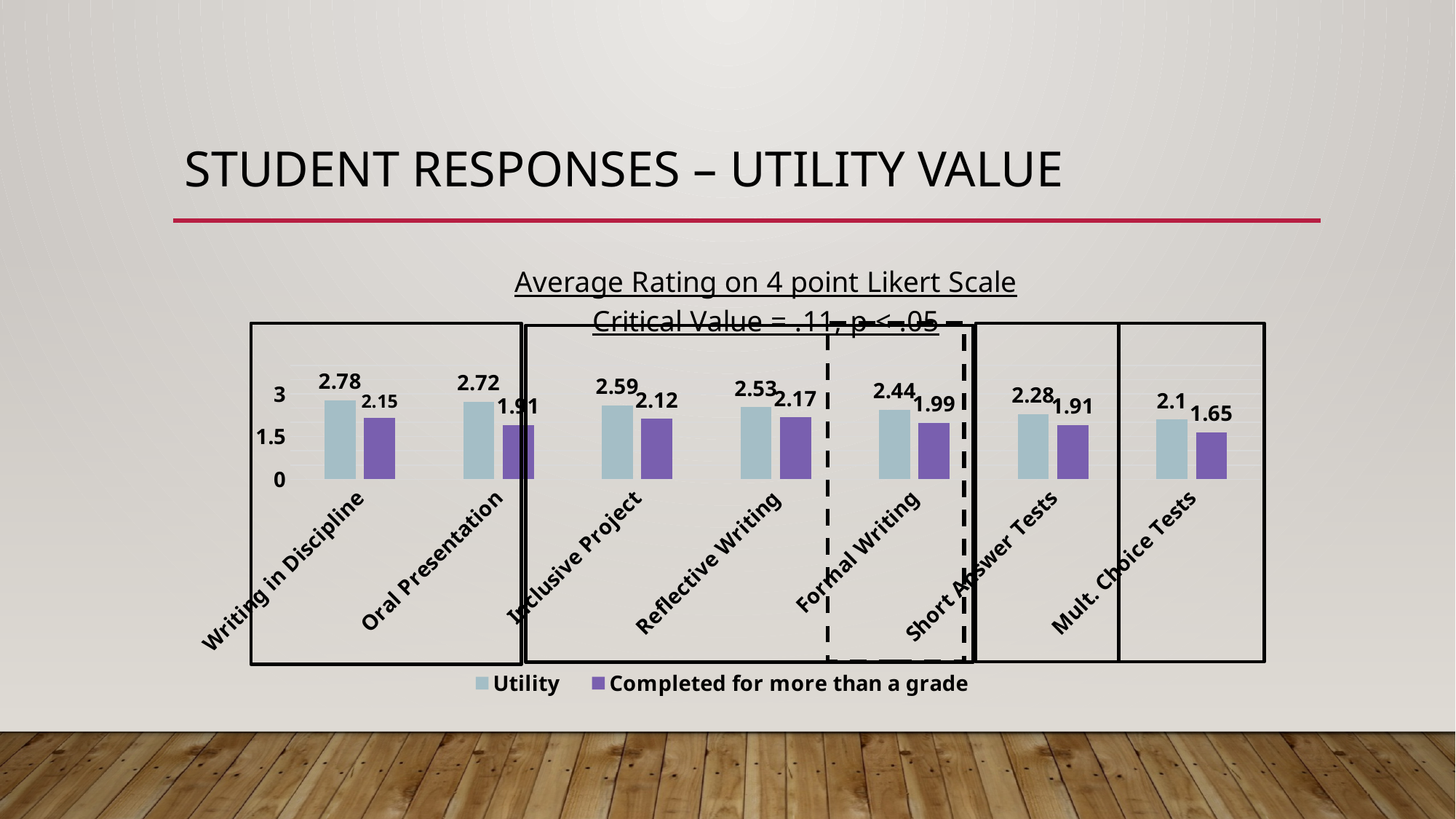
What kind of chart is shown on the slide? bar chart Which category has the highest Utility value? Writing in Discipline Which category has the lowest 'Completed for more than a grade' value? Mult. Choice Tests Which is larger: the Utility value for Formal Writing or the Utility value for Short Answer Tests? Formal Writing What is the Utility value for Writing in Discipline? 2.78 What is the 'Completed for more than a grade' value for Reflective Writing? 2.17 Do the Utility values rise or fall from Writing in Discipline to Mult. Choice Tests? fall What is the difference between the Utility value and the 'Completed for more than a grade' value for Oral Presentation? 0.81 Is the 'Completed for more than a grade' value for Inclusive Project greater or less than 1.5? greater What is the Utility value for Mult. Choice Tests? 2.1 How many series does the legend list? 2 How many categories are shown on the x axis of the chart? 7